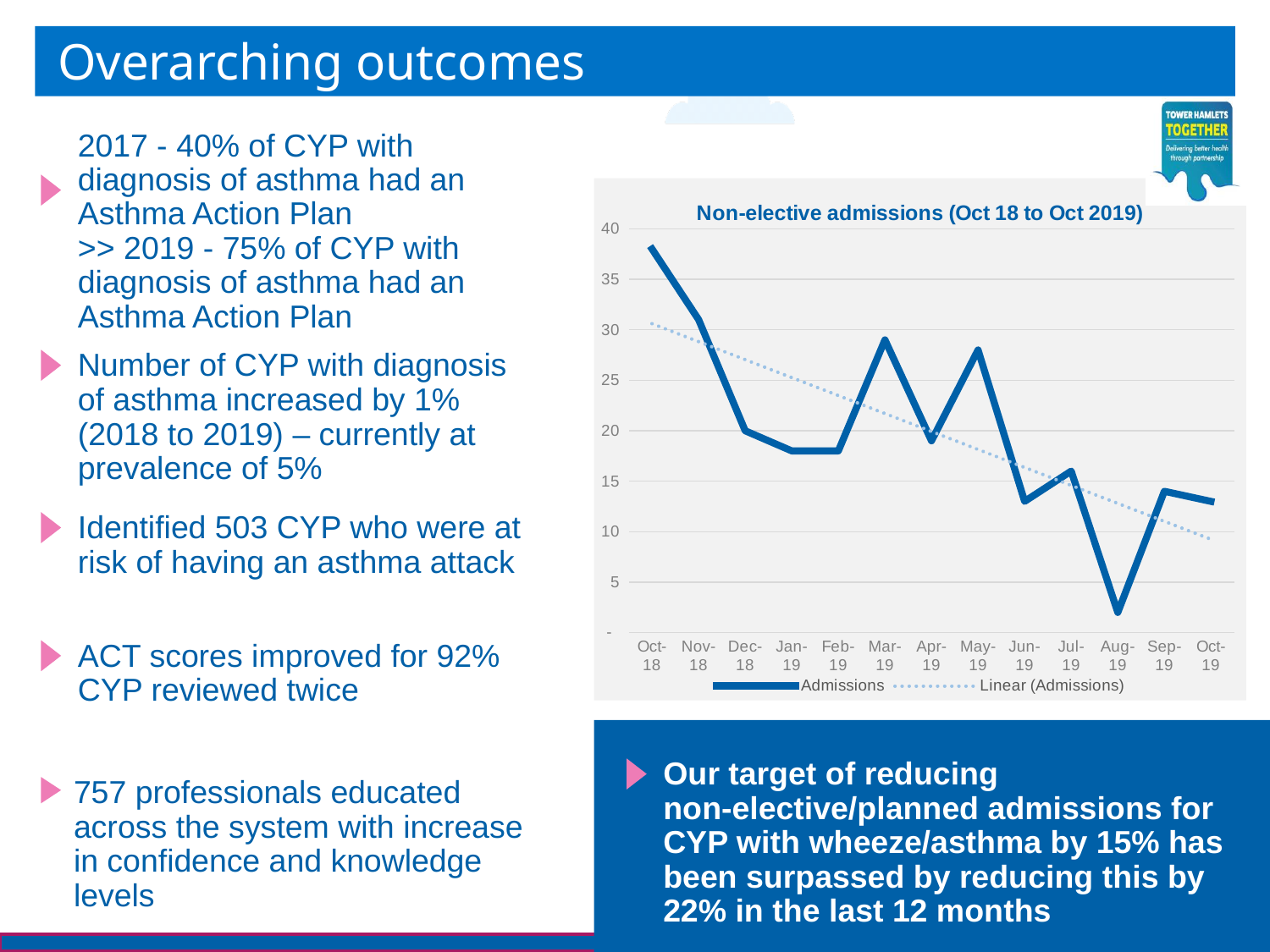
What is the title of the chart? Non-elective admissions (Oct 18 to Oct 2019) Which has more admissions, Oct-18 or Oct-19? Oct-18 Overall, do admissions rise or fall from Oct-18 to Oct-19? fall Which month has the highest number of admissions? Oct-18 What kind of chart is shown on the slide? line chart Which month has the lowest number of admissions? Aug-19 Is the value for Aug-19 greater or less than 5? less How many months are plotted along the x axis of the chart? 13 How many series does the chart legend list? 2 Is the value for Jan-19 greater or less than 20? less Is the value for Oct-18 greater or less than 35? greater